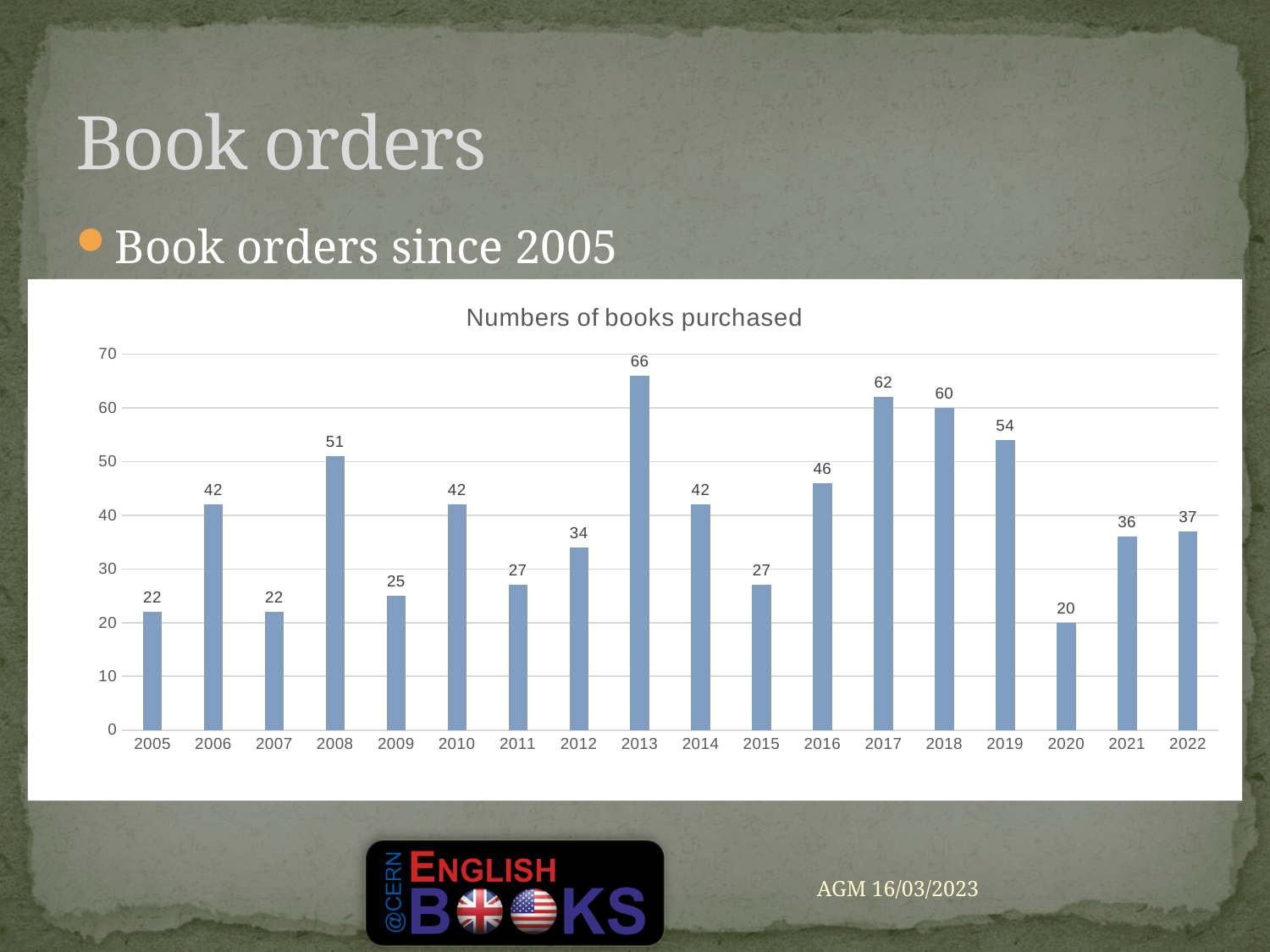
Which year has the lowest number of books purchased? 2020 What kind of chart is shown on the slide? bar chart What is the difference between the number of books purchased in 2013 and in 2020? 46 Is the value for 2022 greater or less than 40? less What is the number of books purchased in 2008? 51 What is the number of books purchased in 2013? 66 What is the difference between the number of books purchased in 2017 and in 2018? 2 Which year had more books purchased, 2016 or 2019? 2019 Which year has the highest number of books purchased? 2013 How many years are shown on the x axis of the chart? 18 What is the title of the chart? Numbers of books purchased What is the number of books purchased in 2020? 20